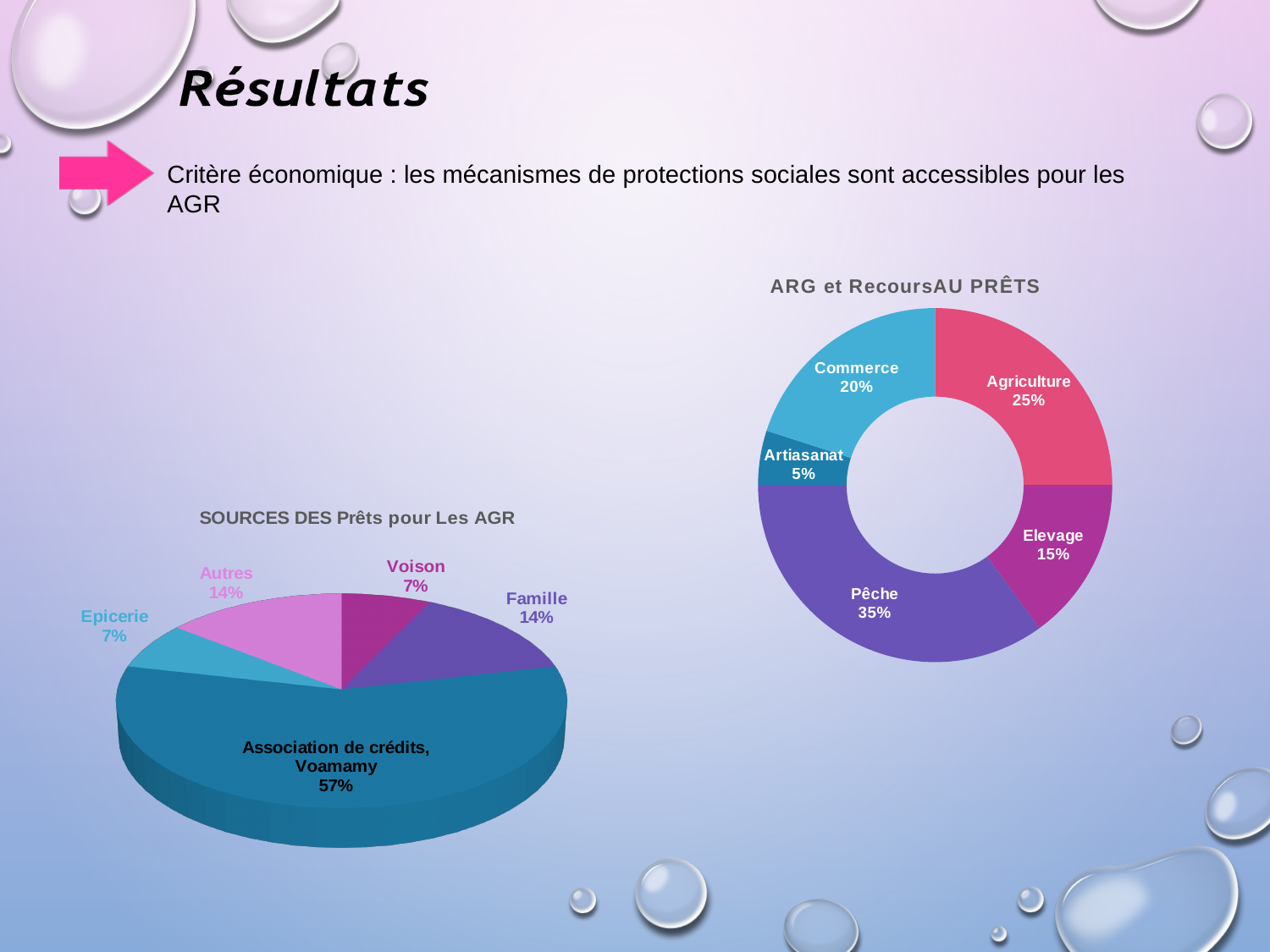
In the 'SOURCES DES Prêts pour Les AGR' chart, which category has the largest share? Association de crédits, Voamamy In the 'SOURCES DES Prêts pour Les AGR' chart, what share is labelled for Autres? 14% In the 'SOURCES DES Prêts pour Les AGR' chart, what is the difference between the shares for Famille and Voison? 7% What kind of chart is 'SOURCES DES Prêts pour Les AGR'? Pie chart In the 'ARG et RecoursAU PRÊTS' chart, what is the difference between the shares for Pêche and Agriculture? 10% In the 'ARG et RecoursAU PRÊTS' chart, what share is labelled for Commerce? 20% In the 'ARG et RecoursAU PRÊTS' chart, which category has the smallest share? Artiasanat In the 'SOURCES DES Prêts pour Les AGR' chart, what share is labelled for Association de crédits, Voamamy? 57% In the 'ARG et RecoursAU PRÊTS' chart, which is larger, Agriculture or Elevage? Agriculture In the 'ARG et RecoursAU PRÊTS' chart, what share is labelled for Pêche? 35% In the 'SOURCES DES Prêts pour Les AGR' chart, how many categories are shown? 5 In the 'ARG et RecoursAU PRÊTS' chart, how many categories are shown? 5